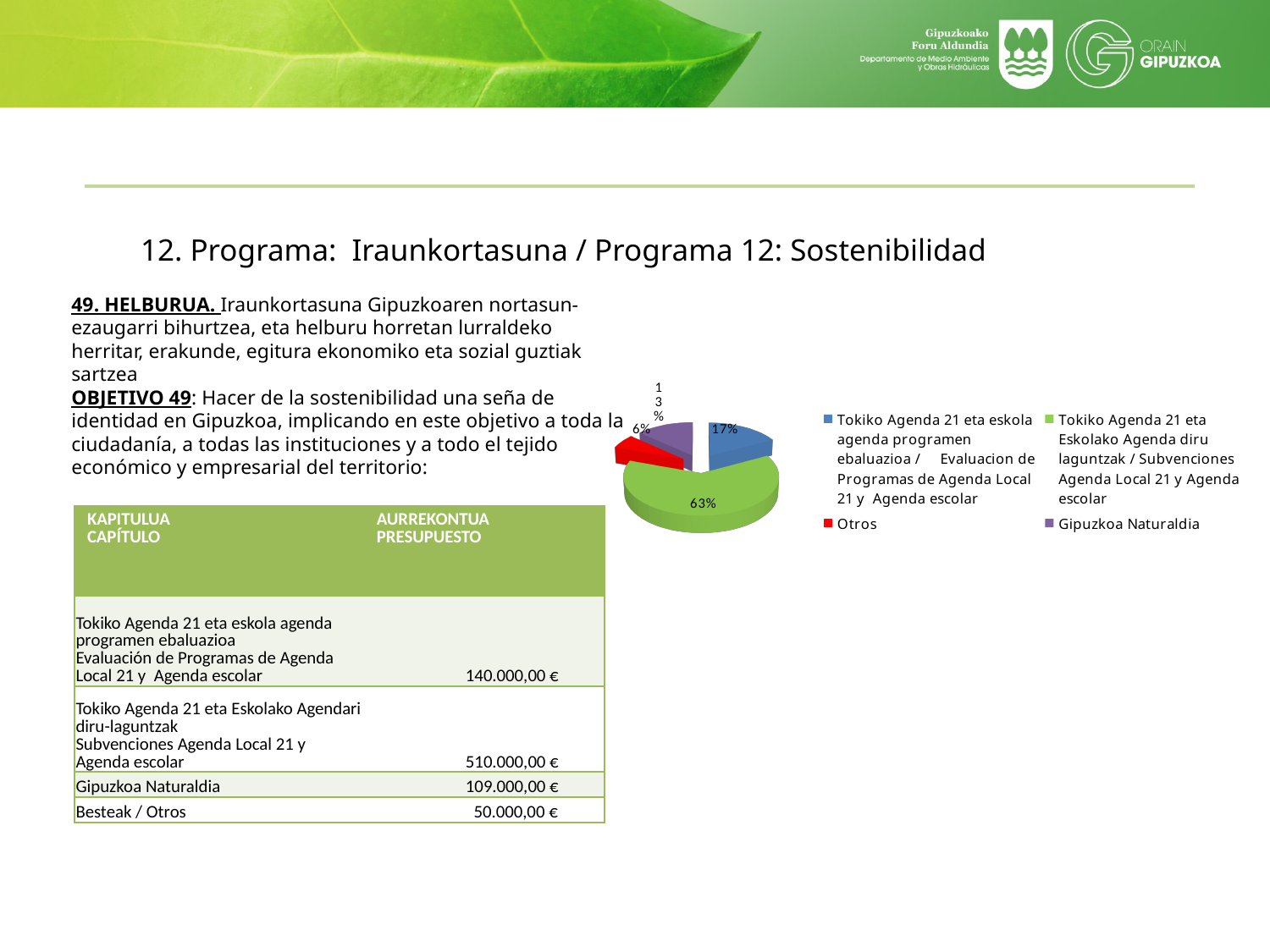
Which slice of the pie chart is the largest? Tokiko Agenda 21 eta Eskolako Agenda diru laguntzak / Subvenciones Agenda Local 21 y Agenda escolar What share of the pie does the Tokiko Agenda 21 eta eskola agenda programen ebaluazioa / Evaluacion de Programas de Agenda Local 21 y Agenda escolar slice represent? 17% How many slices does the pie chart have? 4 Which is larger in the pie chart: the Otros slice or the Gipuzkoa Naturaldia slice? Gipuzkoa Naturaldia What kind of chart is shown on the slide? pie chart What is the difference in percentage points between the largest slice (63%) and the Gipuzkoa Naturaldia slice (13%)? 50 What colour is the Otros slice in the pie chart? red How many entries does the legend of the pie chart list? 4 Which slice of the pie chart is the smallest? Otros What share of the pie does the Tokiko Agenda 21 eta Eskolako Agenda diru laguntzak / Subvenciones Agenda Local 21 y Agenda escolar slice represent? 63% What share of the pie does the Otros slice represent? 6%